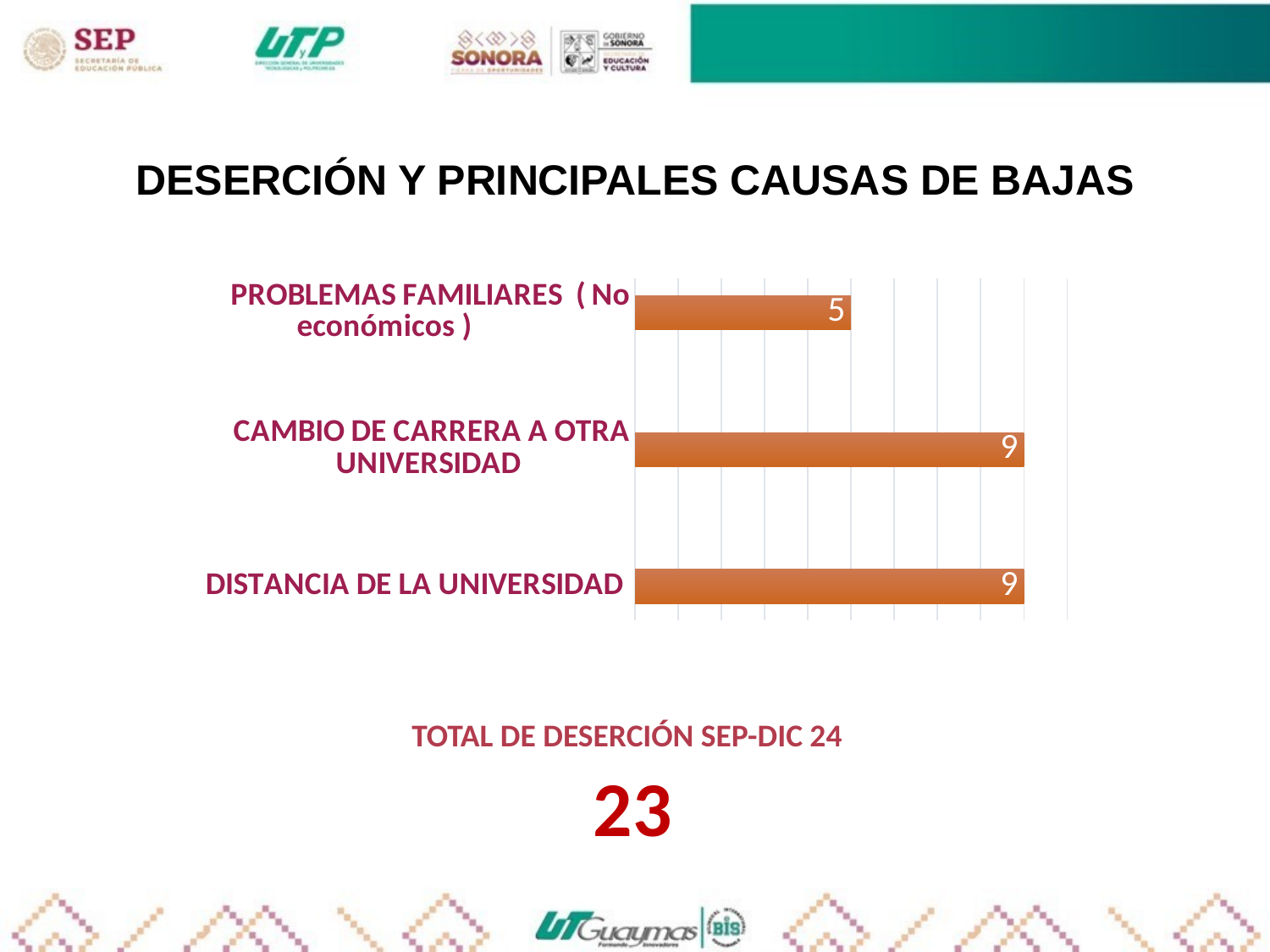
Which is larger, the value for CAMBIO DE CARRERA A OTRA UNIVERSIDAD or the value for PROBLEMAS FAMILIARES (No económicos)? CAMBIO DE CARRERA A OTRA UNIVERSIDAD What colour are the bars in the chart? Orange Do CAMBIO DE CARRERA A OTRA UNIVERSIDAD and DISTANCIA DE LA UNIVERSIDAD have the same value? Yes What is the title of the slide containing the chart? DESERCIÓN Y PRINCIPALES CAUSAS DE BAJAS What kind of chart is shown on the slide? Bar chart What is the sum of the three values shown in the chart? 23 What is the value for PROBLEMAS FAMILIARES (No económicos)? 5 Which category has the lowest value? PROBLEMAS FAMILIARES (No económicos) How many categories are shown in the chart? 3 What is the value for DISTANCIA DE LA UNIVERSIDAD? 9 What is the value for CAMBIO DE CARRERA A OTRA UNIVERSIDAD? 9 What is the difference between the value for DISTANCIA DE LA UNIVERSIDAD and the value for PROBLEMAS FAMILIARES (No económicos)? 4